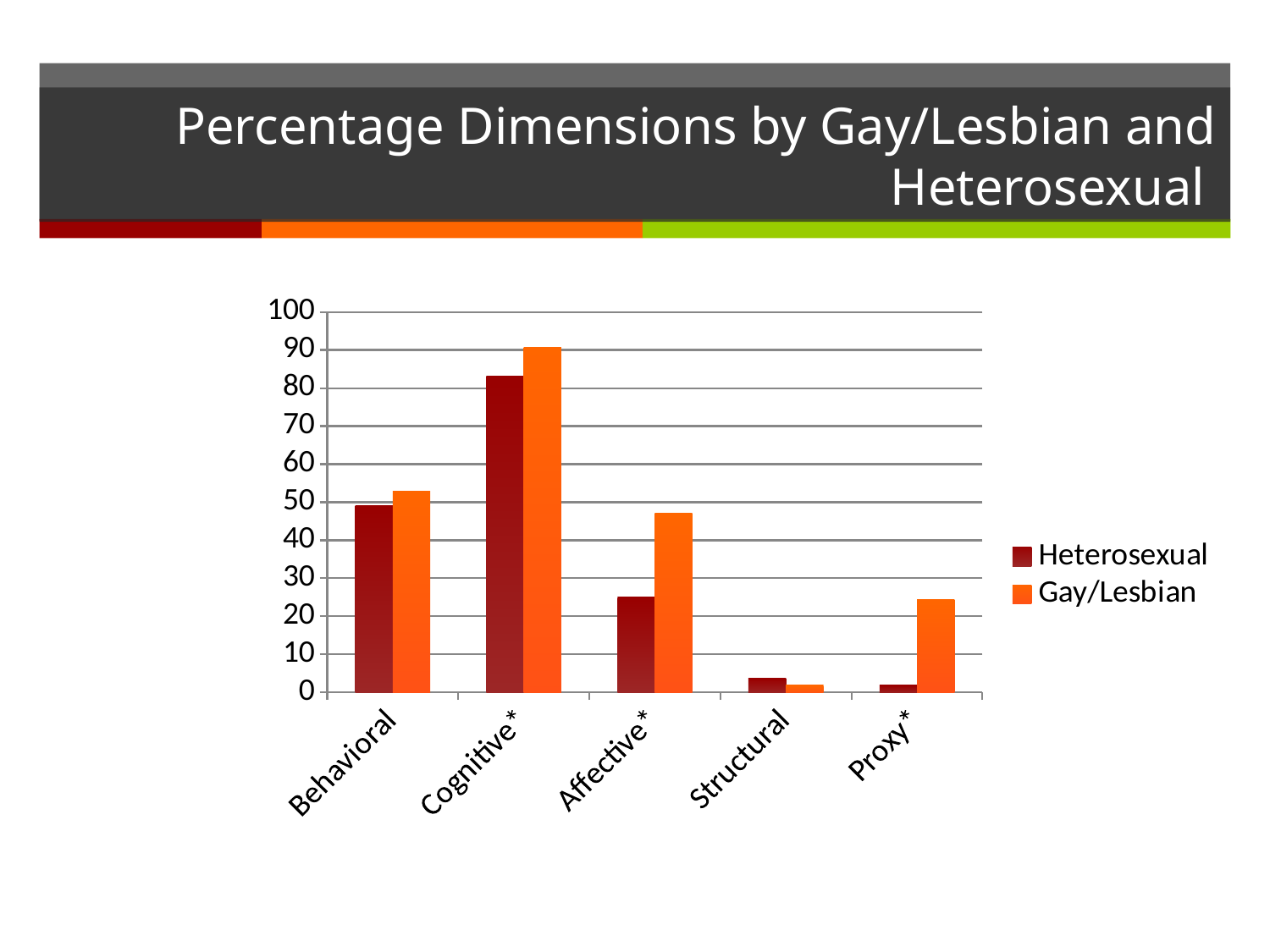
For Structural, which series has the larger value, Heterosexual or Gay/Lesbian? Heterosexual Which category has the highest Heterosexual value? Cognitive* How many series does the legend list? 2 How many categories are shown on the x axis of the chart? 5 What kind of chart is shown on the slide? bar chart Is the Gay/Lesbian value for Affective* greater or less than 40? greater Is the Heterosexual value for Cognitive* greater or less than 80? greater Which category has the lowest Gay/Lesbian value? Structural Is the Heterosexual value for Affective* greater or less than 30? less Which category has the highest Gay/Lesbian value? Cognitive* What colour represents the Gay/Lesbian series in the legend? orange For Affective*, which series has the larger value, Heterosexual or Gay/Lesbian? Gay/Lesbian